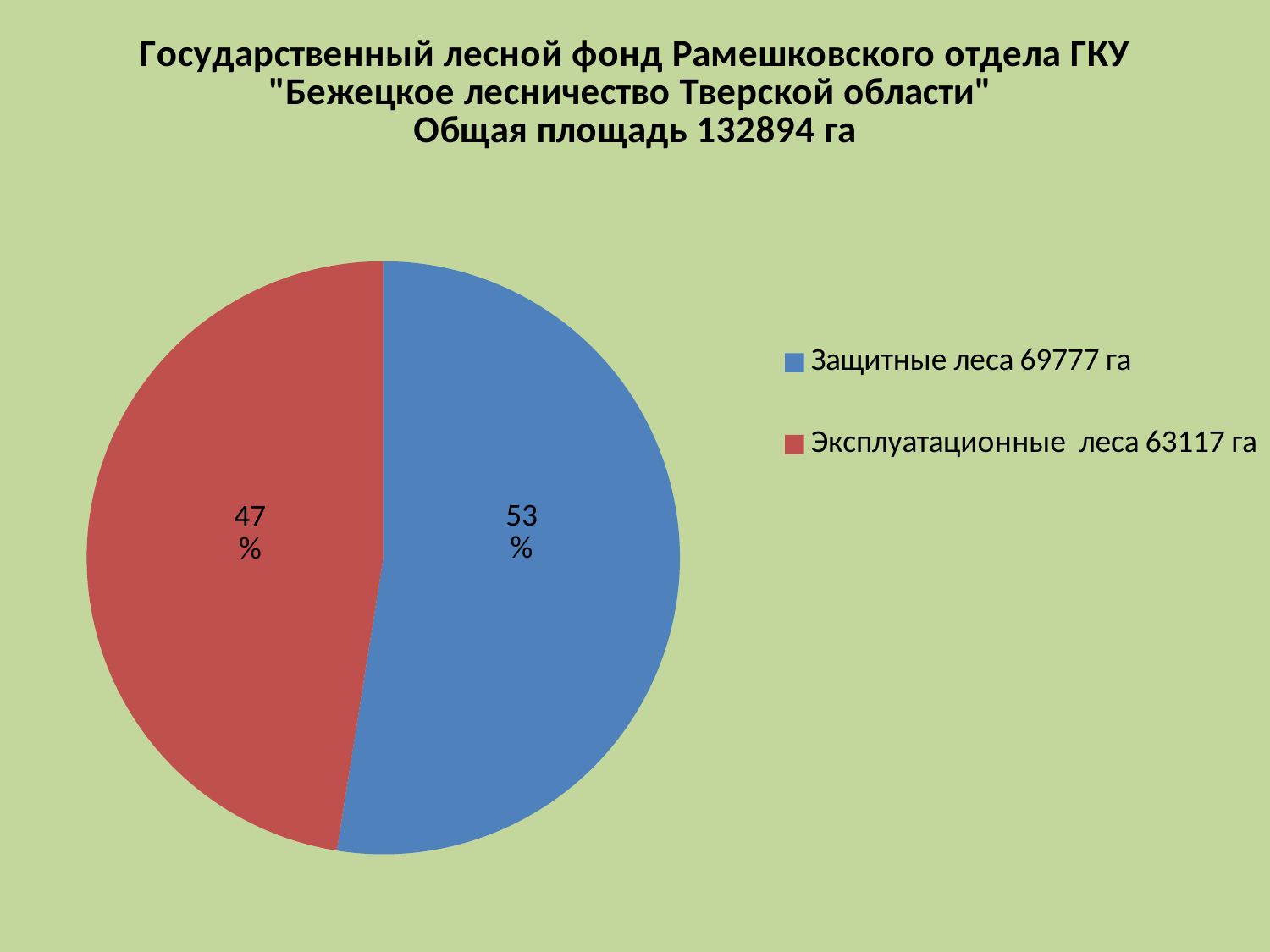
How many slices does the pie chart have? 2 What share of the pie does Защитные леса take? 53% Which slice is the smallest? Эксплуатационные леса Which slice is the largest? Защитные леса What kind of chart is shown on the slide? pie chart What colour is the slice for Эксплуатационные леса? red What area in hectares does the legend give for Эксплуатационные леса? 63117 га What area in hectares does the legend give for Защитные леса? 69777 га How many entries does the legend list? 2 What share of the pie does Эксплуатационные леса take? 47% Which is larger, the share for Защитные леса or for Эксплуатационные леса? Защитные леса What is the difference in percentage points between the Защитные леса slice and the Эксплуатационные леса slice? 6